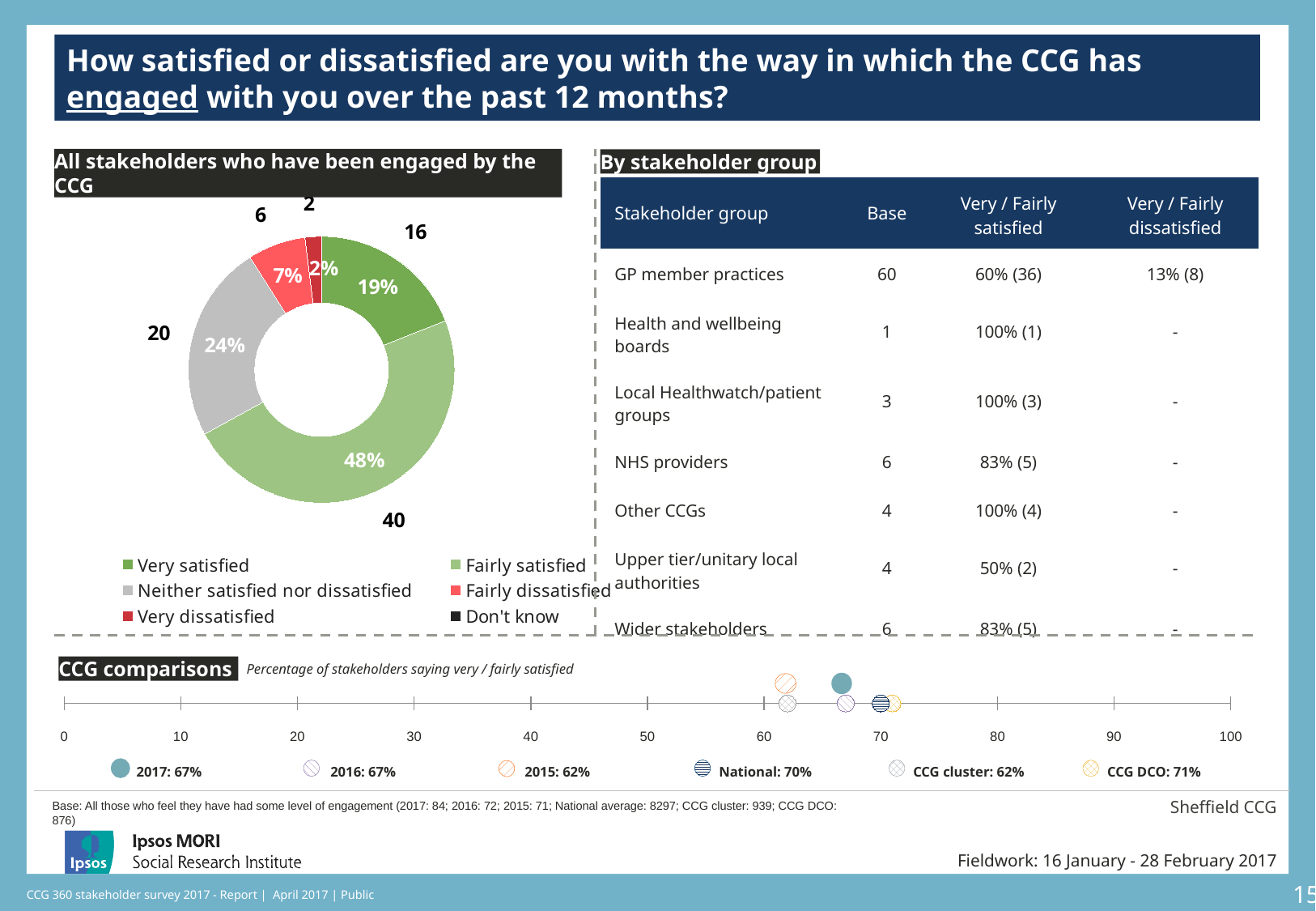
In the donut chart for all stakeholders engaged by the CCG, what percentage were fairly satisfied? 48% What type of chart is used for all stakeholders who have been engaged by the CCG? Pie (donut) chart In the donut chart for all stakeholders engaged by the CCG, what is the difference in percentage points between fairly satisfied and very satisfied? 29 percentage points In the donut chart for all stakeholders engaged by the CCG, how many respondents were very satisfied? 16 In the donut chart for all stakeholders engaged by the CCG, which is larger: the share neither satisfied nor dissatisfied or the share very satisfied? Neither satisfied nor dissatisfied In the donut chart for all stakeholders engaged by the CCG, which plotted category has the smallest share? Very dissatisfied In the CCG comparisons chart, which comparator has the highest percentage saying very / fairly satisfied? CCG DCO: 71% In the donut chart for all stakeholders engaged by the CCG, which category has the largest share? Fairly satisfied In the CCG comparisons chart, what percentage of stakeholders said very / fairly satisfied in 2017? 67% In the donut chart for all stakeholders engaged by the CCG, what percentage were neither satisfied nor dissatisfied? 24% In the donut chart for all stakeholders engaged by the CCG, what is the combined percentage of very satisfied and fairly satisfied? 67% How many categories does the legend of the donut chart for all stakeholders engaged by the CCG list? 6